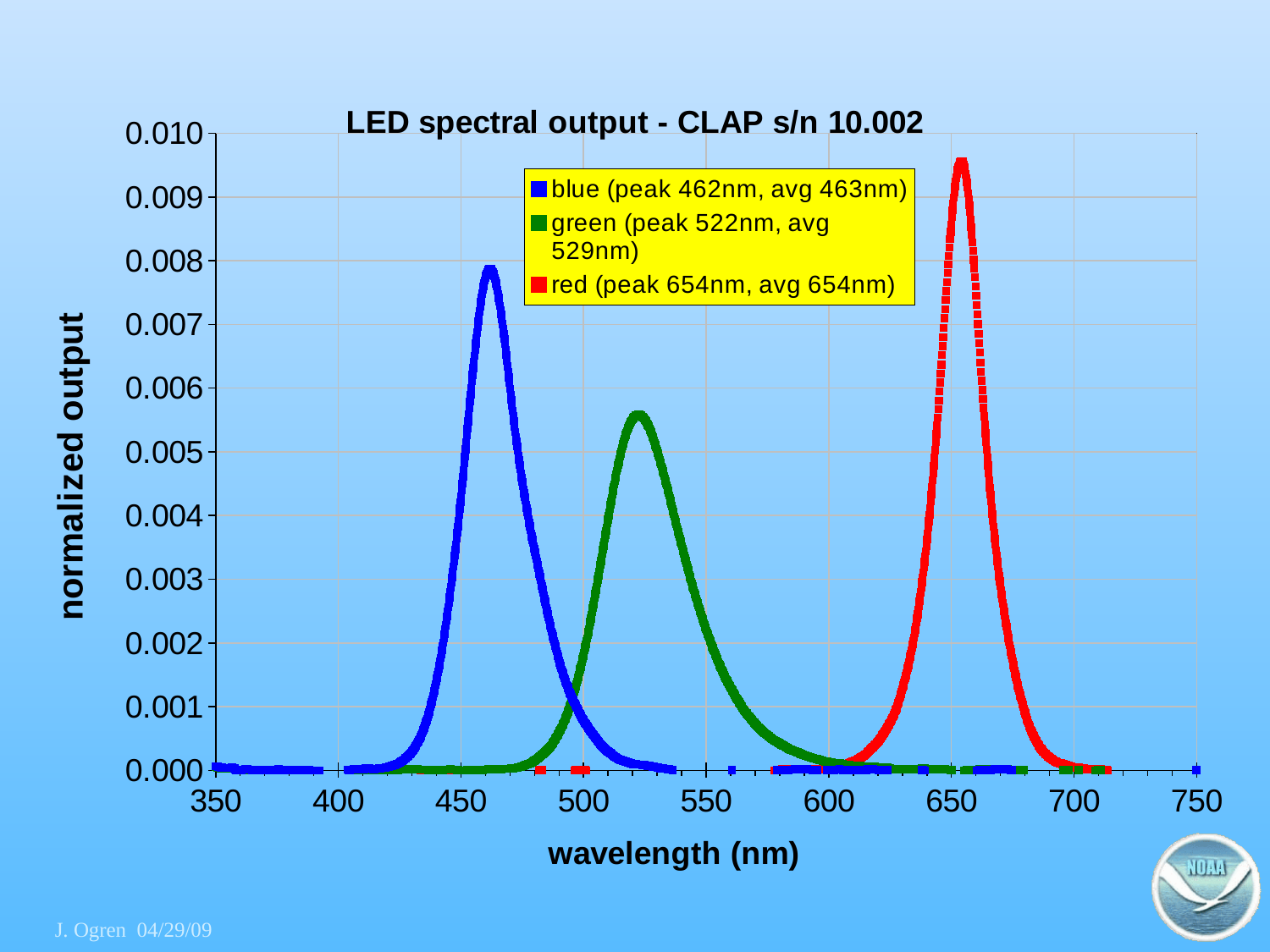
What is the label of the x axis? wavelength (nm) How many series does the legend list? 3 Is the peak value of the blue series greater or less than 0.007? greater According to the legend, what is the average wavelength of the red LED? 654nm Is the peak value of the green series greater or less than 0.005? greater Which series reaches the highest normalized output? red According to the legend, at what wavelength does the blue LED peak? 462nm According to the legend, at what wavelength does the green LED peak? 522nm What is the title of the chart? LED spectral output - CLAP s/n 10.002 Which series has a higher peak, blue or green? blue Is the peak value of the red series greater or less than 0.009? greater Which series has the lowest peak normalized output? green